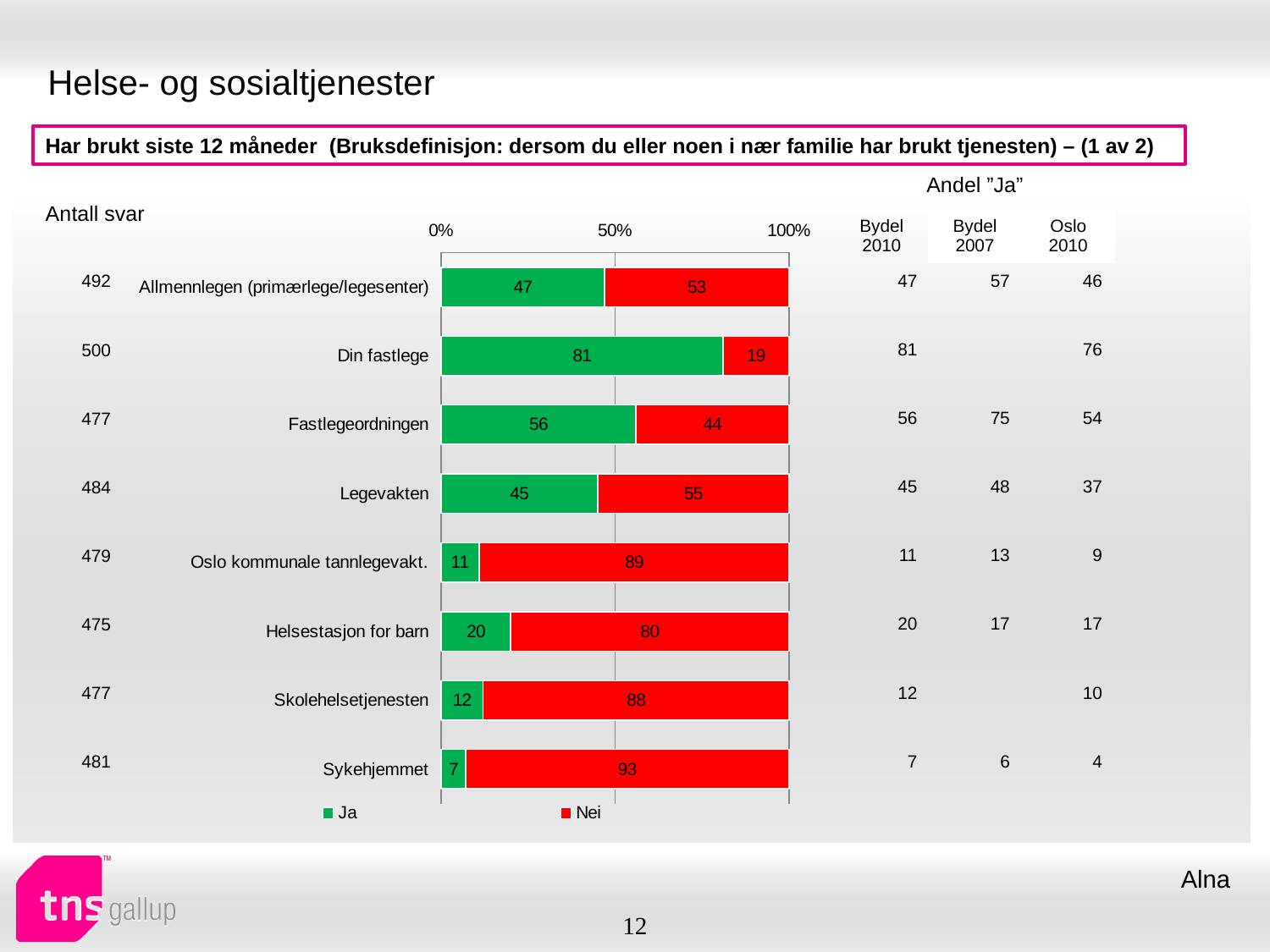
What is the total of the stacked bar for Helsestasjon for barn? 100 Which category has the highest "Ja" value? Din fastlege Which is larger: the "Ja" value for Fastlegeordningen or the "Ja" value for Legevakten? Fastlegeordningen What is the "Ja" value for Din fastlege? 81 Which category has the lowest "Ja" value? Sykehjemmet How many series does the legend list? 2 What colour represents the "Nei" series in the chart? Red What is the difference between the "Nei" value for Sykehjemmet and the "Nei" value for Din fastlege? 74 How many categories are shown in the chart? 8 What kind of chart is shown on the slide? Stacked bar chart What is the "Nei" value for Oslo kommunale tannlegevakt.? 89 Is the "Ja" value for Allmennlegen (primærlege/legesenter) greater or less than 50%? less